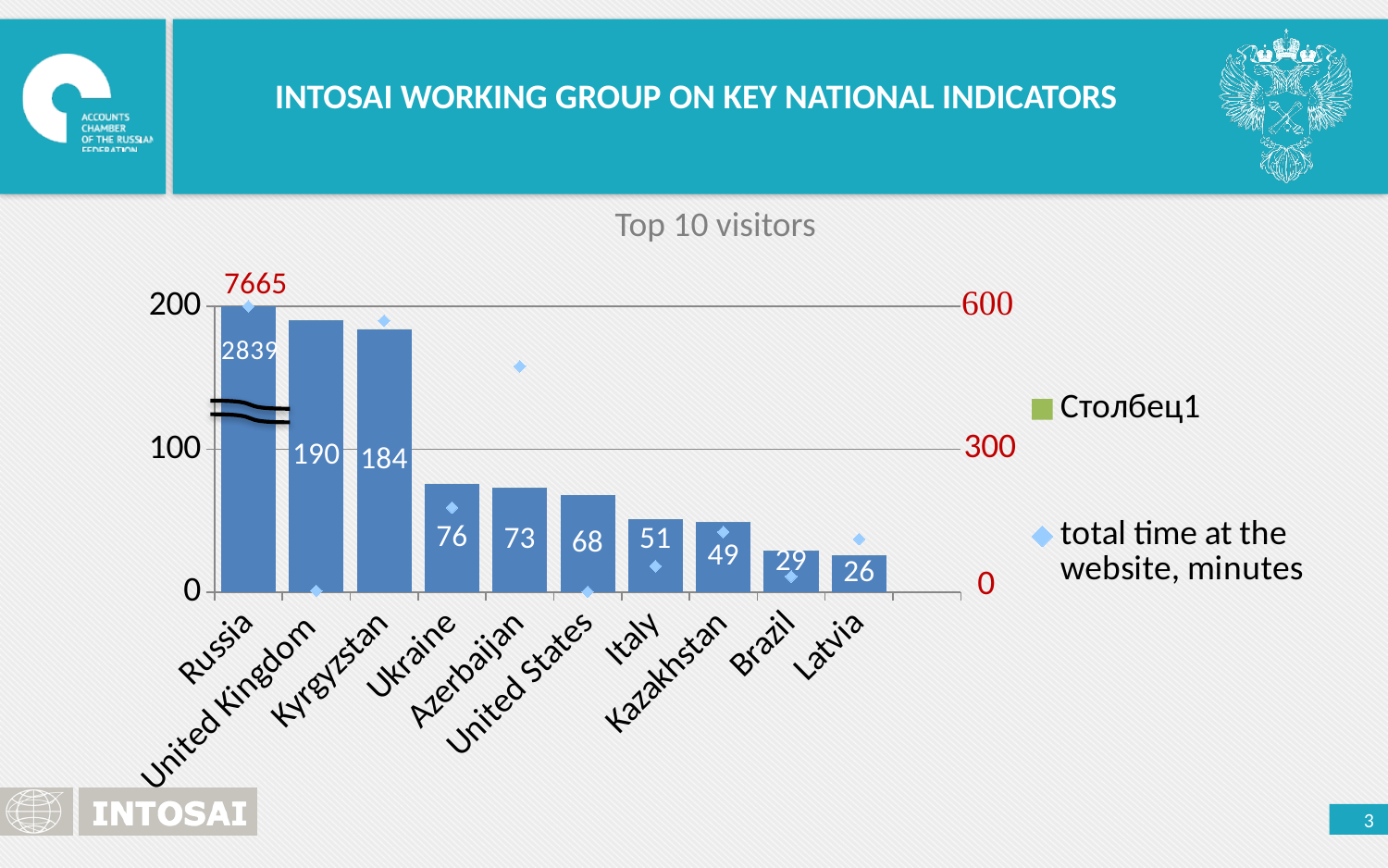
How many countries are shown on the x axis? 10 What is the value of the bar for Kyrgyzstan? 184 What is the value of the bar for Ukraine? 76 How many series does the legend list? 2 What is the total time at the website, in minutes, labelled for Russia? 7665 What is the value of the bar for Latvia? 26 Which country has the lowest bar value? Latvia Which country has the highest bar value? Russia Which has a larger bar value, Italy or Kazakhstan? Italy What is the value of the bar for United Kingdom? 190 What is the difference between the bar values for United Kingdom and Kyrgyzstan? 6 What is the title of the chart? Top 10 visitors